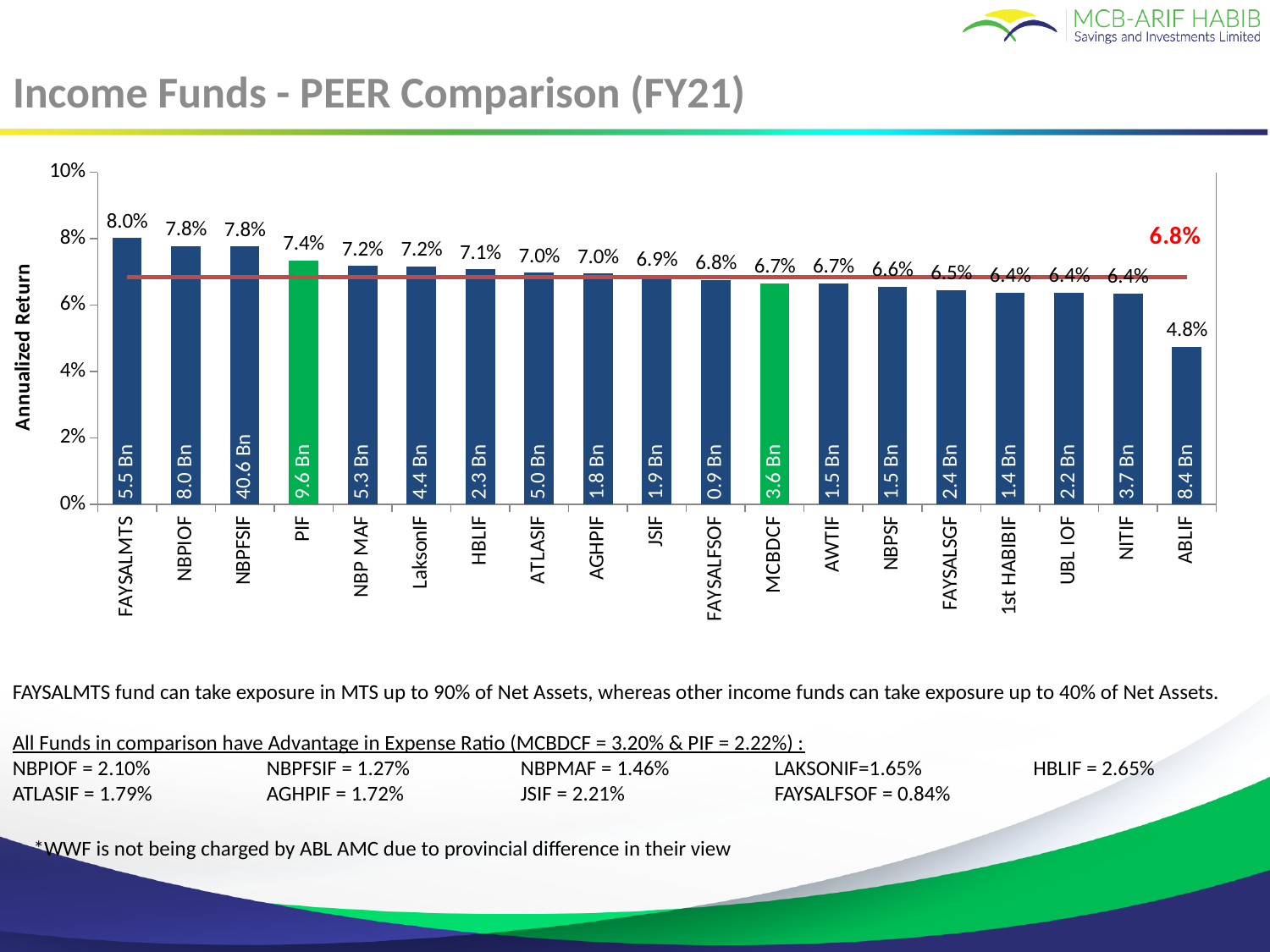
How many funds are shown on the chart? 19 What is the label of the vertical axis? Annualized Return Which fund has the lowest annualized return? ABLIF What type of chart is shown on the slide? Bar chart Which has a higher annualized return, PIF or MCBDCF? PIF What is the annualized return for FAYSALMTS? 8.0% What value is marked by the red horizontal line on the chart? 6.8% Which fund has the highest annualized return? FAYSALMTS What is the difference in annualized return between FAYSALMTS and ABLIF? 3.2% What is the annualized return for MCBDCF? 6.7% What is the annualized return for PIF? 7.4% What net asset size is printed inside the NBPFSIF bar? 40.6 Bn